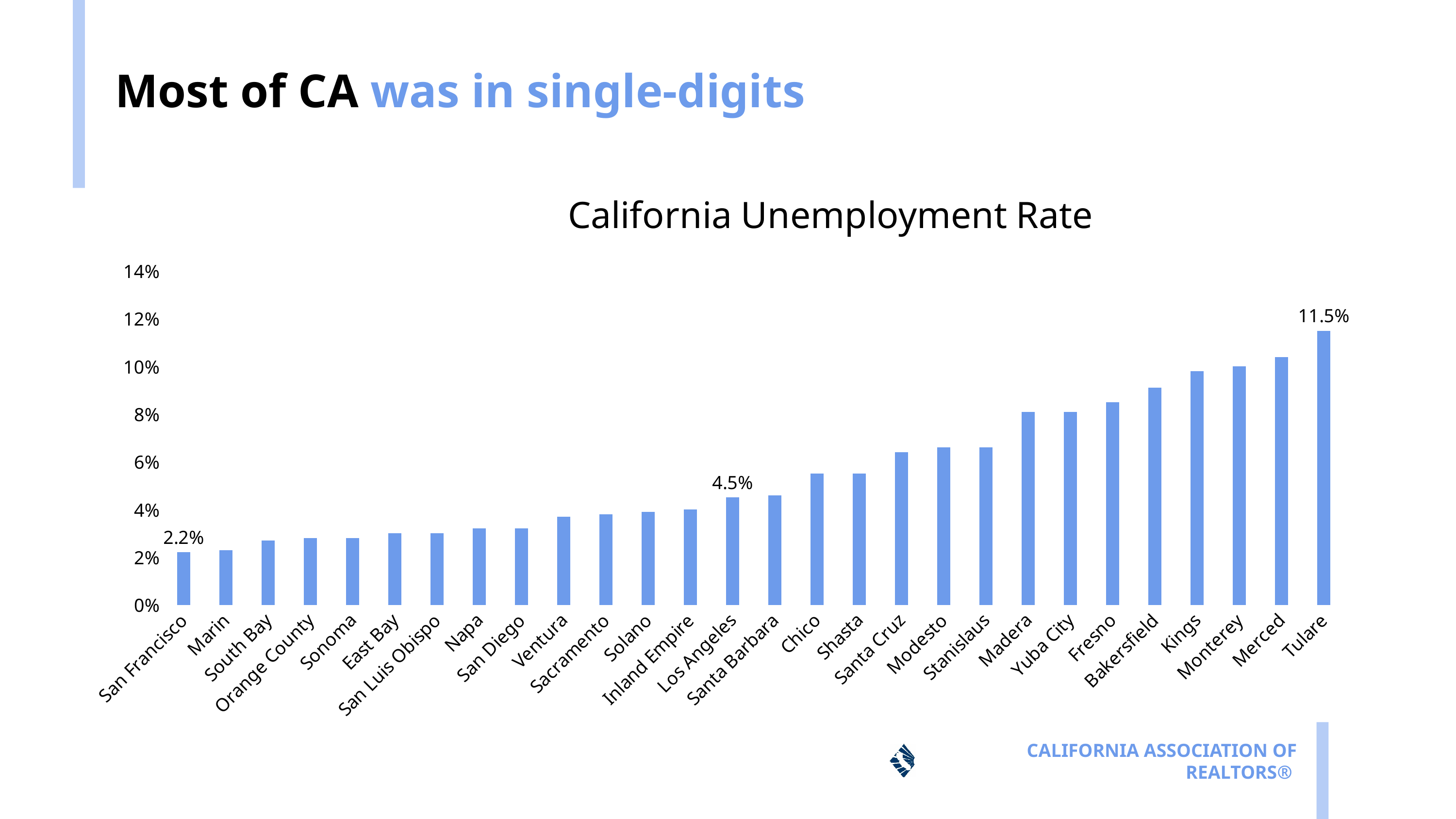
Which region has the lowest unemployment rate? San Francisco Which region has the highest unemployment rate? Tulare Do the unemployment rates rise or fall moving from left to right along the x axis? Rise Is the value for Merced greater or less than 10%? greater Which has a higher unemployment rate, Fresno or Chico? Fresno What is the unemployment rate for Los Angeles? 4.5% What is the title of the chart? California Unemployment Rate What is the unemployment rate for Tulare? 11.5% What is the unemployment rate for San Francisco? 2.2% What is the difference in percentage points between Tulare's and San Francisco's unemployment rates? 9.3 percentage points What type of chart is shown on the slide? Bar chart How many regions are shown on the x axis? 28